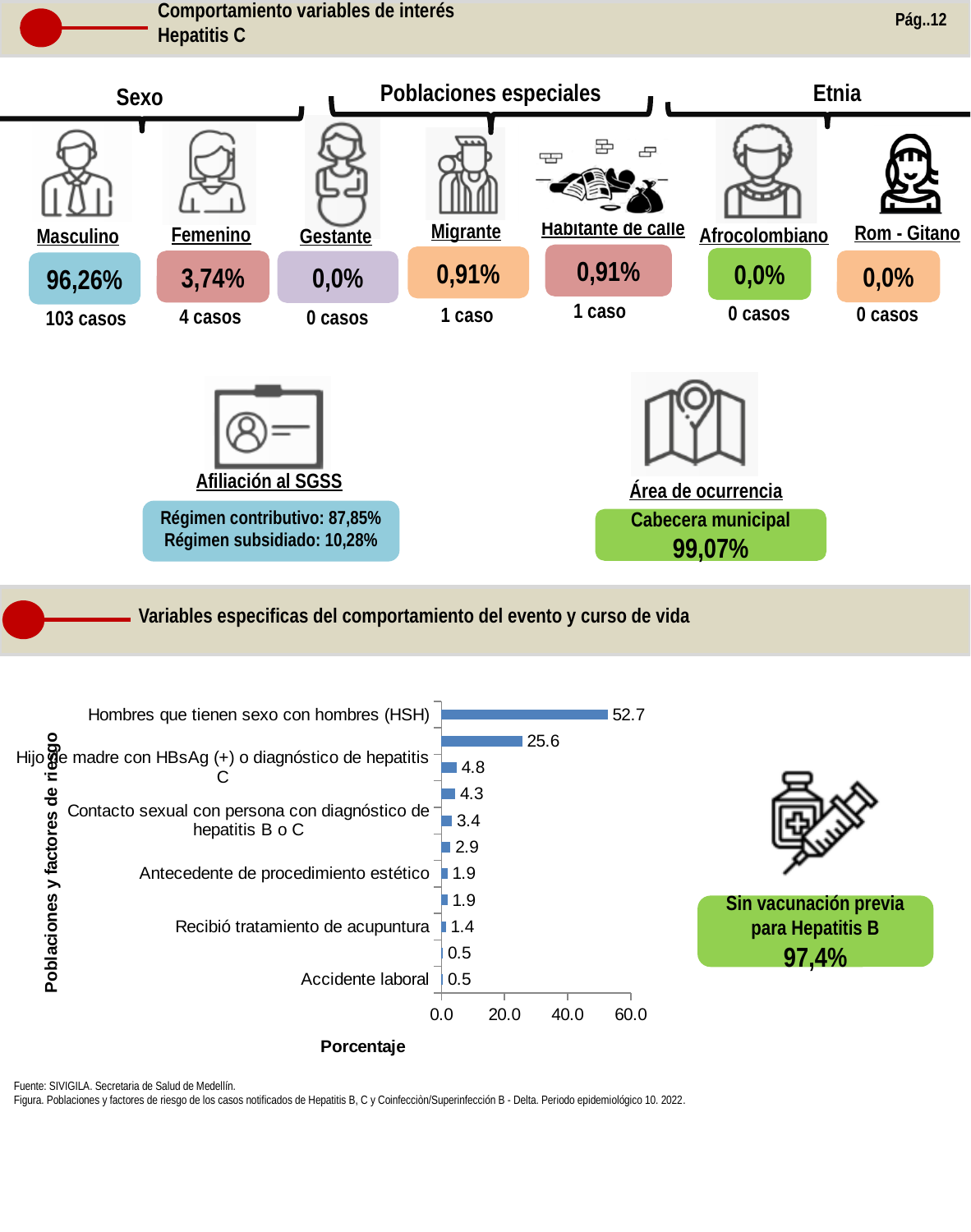
What is the difference between the value for Hombres que tienen sexo con hombres (HSH) and the value for Hijo de madre con HBsAg (+) o diagnóstico de hepatitis C? 47.9 What is the value for Accidente laboral in the bar chart? 0.5 What kind of chart is shown at the bottom of the slide? Bar chart Which category has the highest value in the bar chart? Hombres que tienen sexo con hombres (HSH) What is the value for Antecedente de procedimiento estético in the bar chart? 1.9 Which is larger in the bar chart: the value for Contacto sexual con persona con diagnóstico de hepatitis B o C or the value for Recibió tratamiento de acupuntura? Contacto sexual con persona con diagnóstico de hepatitis B o C What is the value for Recibió tratamiento de acupuntura in the bar chart? 1.4 What is the value for Hijo de madre con HBsAg (+) o diagnóstico de hepatitis C in the bar chart? 4.8 Is the value for Hombres que tienen sexo con hombres (HSH) greater or less than 40.0? greater What is the value for Contacto sexual con persona con diagnóstico de hepatitis B o C in the bar chart? 3.4 How many bars are plotted in the bar chart? 11 What is the value for Hombres que tienen sexo con hombres (HSH) in the bar chart? 52.7